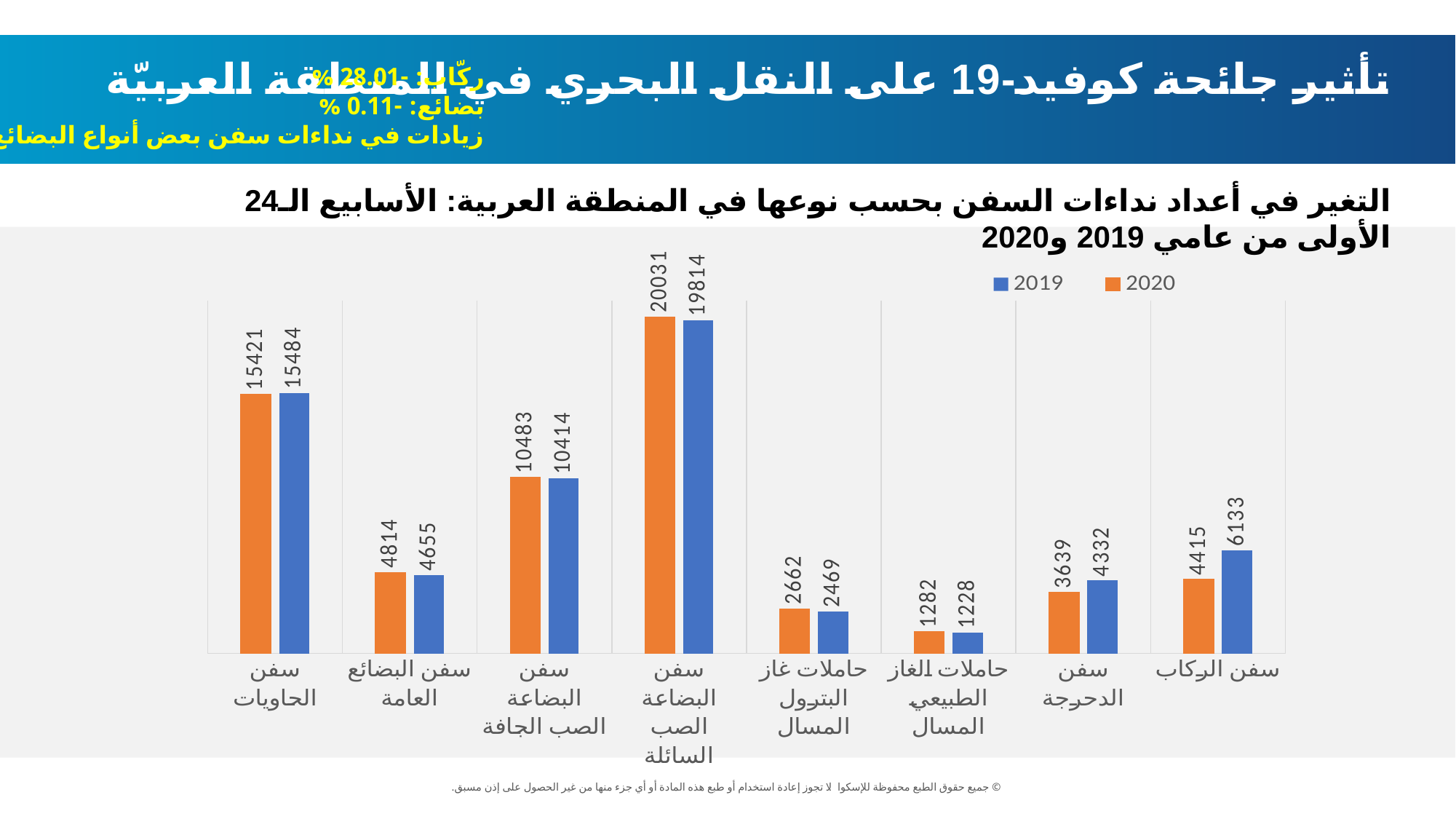
What is the difference between the 2019 and 2020 values for سفن الركاب (passenger ships)? 1718 What is the 2019 value for سفن الركاب (passenger ships)? 6133 Which category has the highest 2020 value? سفن البضاعة الصب السائلة Which colour represents the 2020 series in the legend? orange How many ship-type categories are shown on the x axis? 8 What is the 2020 value for حاملات الغاز الطبيعي المسال (LNG carriers)? 1282 Which category has the lowest 2019 value? حاملات الغاز الطبيعي المسال What is the difference between the 2020 and 2019 values for سفن البضاعة الصب السائلة (liquid bulk ships)? 217 What type of chart is shown on the slide? bar chart How many series does the legend list? 2 What is the 2020 value for سفن الحاويات (container ships)? 15421 For سفن الدحرجة (ro-ro ships), which year has the larger value, 2019 or 2020? 2019